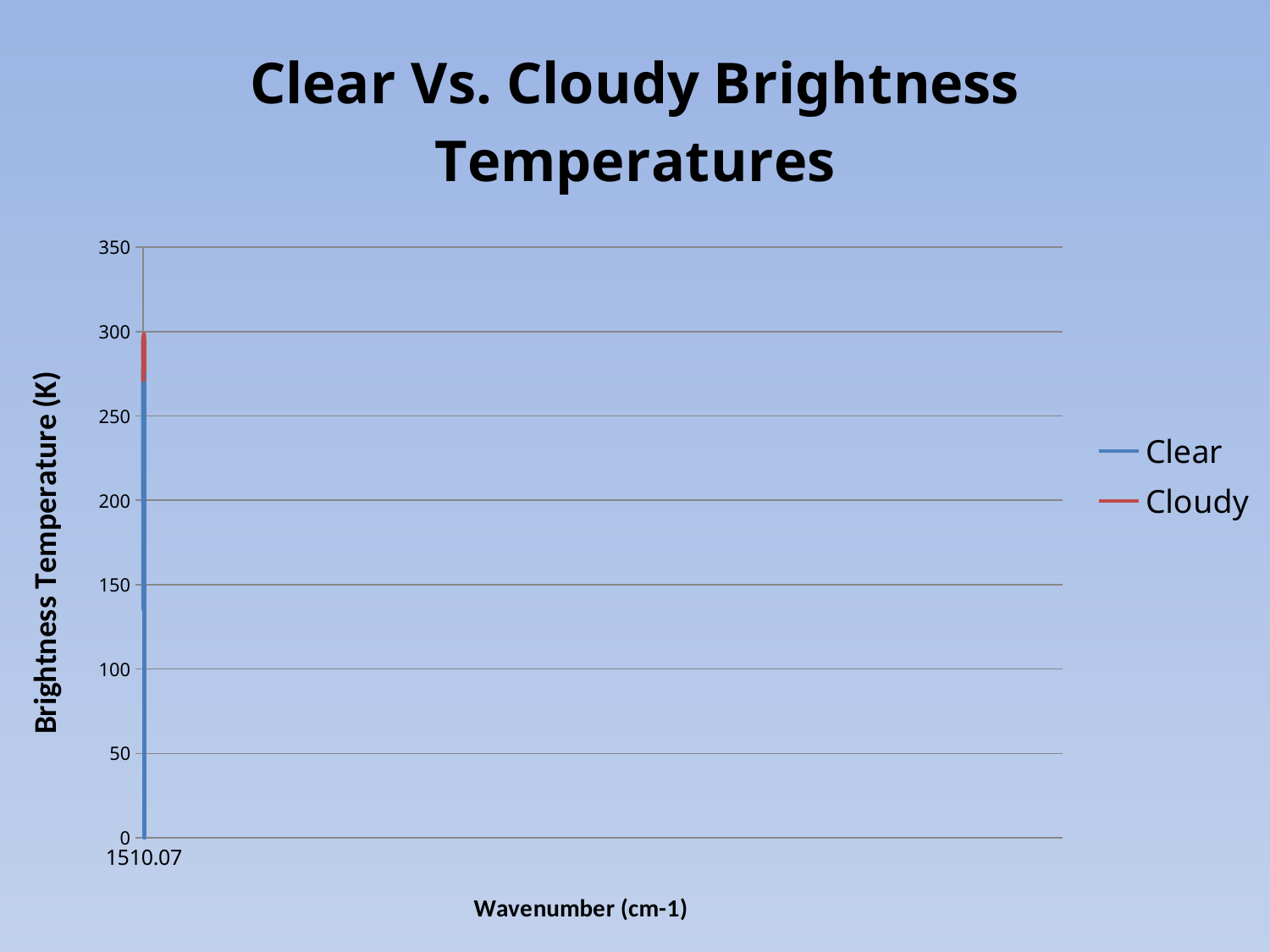
Is the highest value of the Cloudy series greater or less than 250? greater What kind of chart is shown on the slide? line chart How many series does the legend list? 2 What is the label of the vertical axis? Brightness Temperature (K) What is the title of the chart? Clear Vs. Cloudy Brightness Temperatures